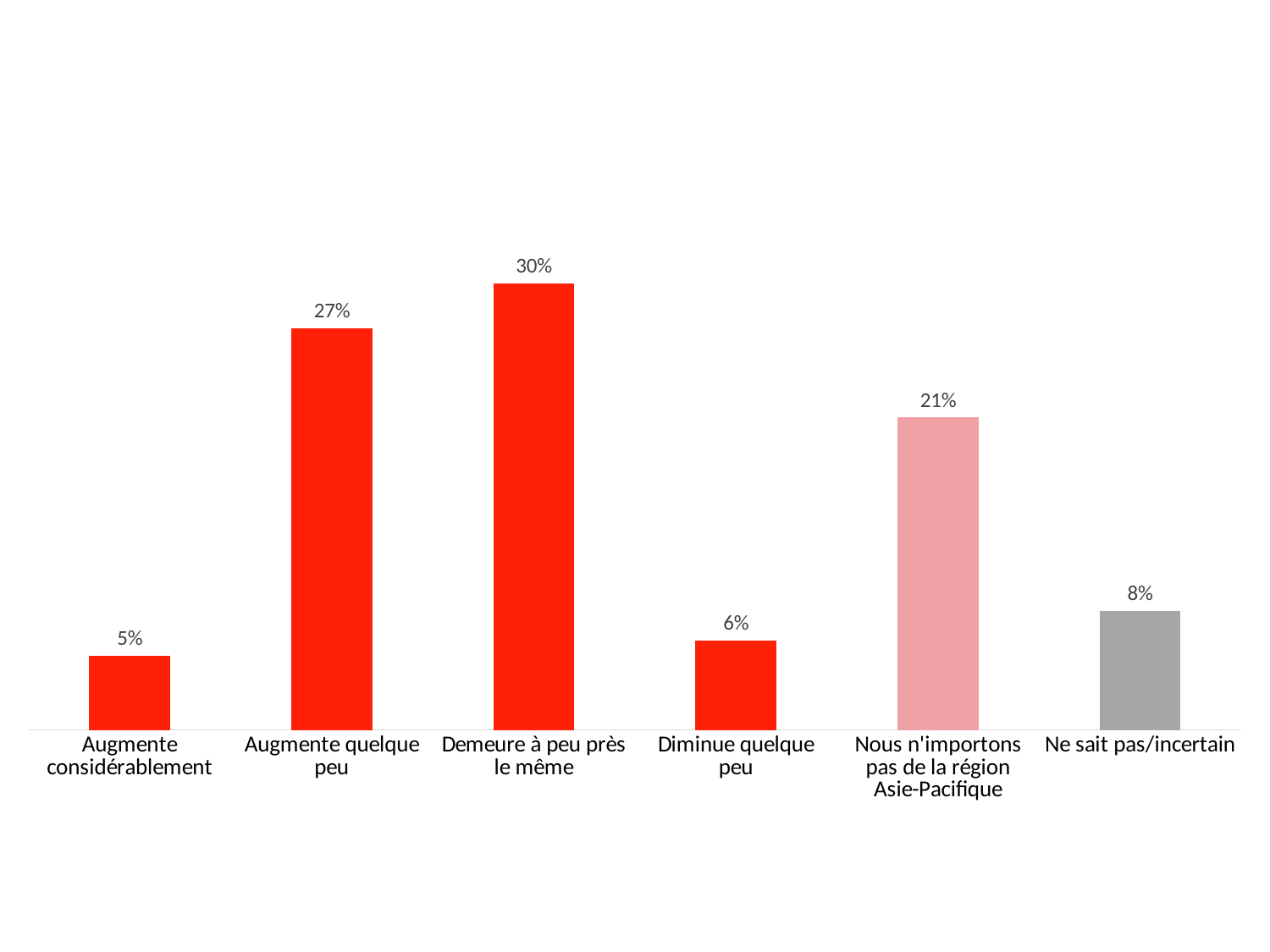
Which category has the highest value? Demeure à peu près le même What is the value for "Demeure à peu près le même"? 30% What is the difference between "Demeure à peu près le même" and "Augmente quelque peu"? 3% How many categories are shown on the chart? 6 What is the value for "Nous n'importons pas de la région Asie-Pacifique"? 21% What is the difference between "Augmente quelque peu" and "Diminue quelque peu"? 21% Which is larger, "Augmente quelque peu" or "Nous n'importons pas de la région Asie-Pacifique"? Augmente quelque peu What is the value for "Augmente considérablement"? 5% What kind of chart is this? Bar chart Which category has the lowest value? Augmente considérablement What is the value for "Ne sait pas/incertain"? 8% What colour is the bar for "Ne sait pas/incertain"? Grey